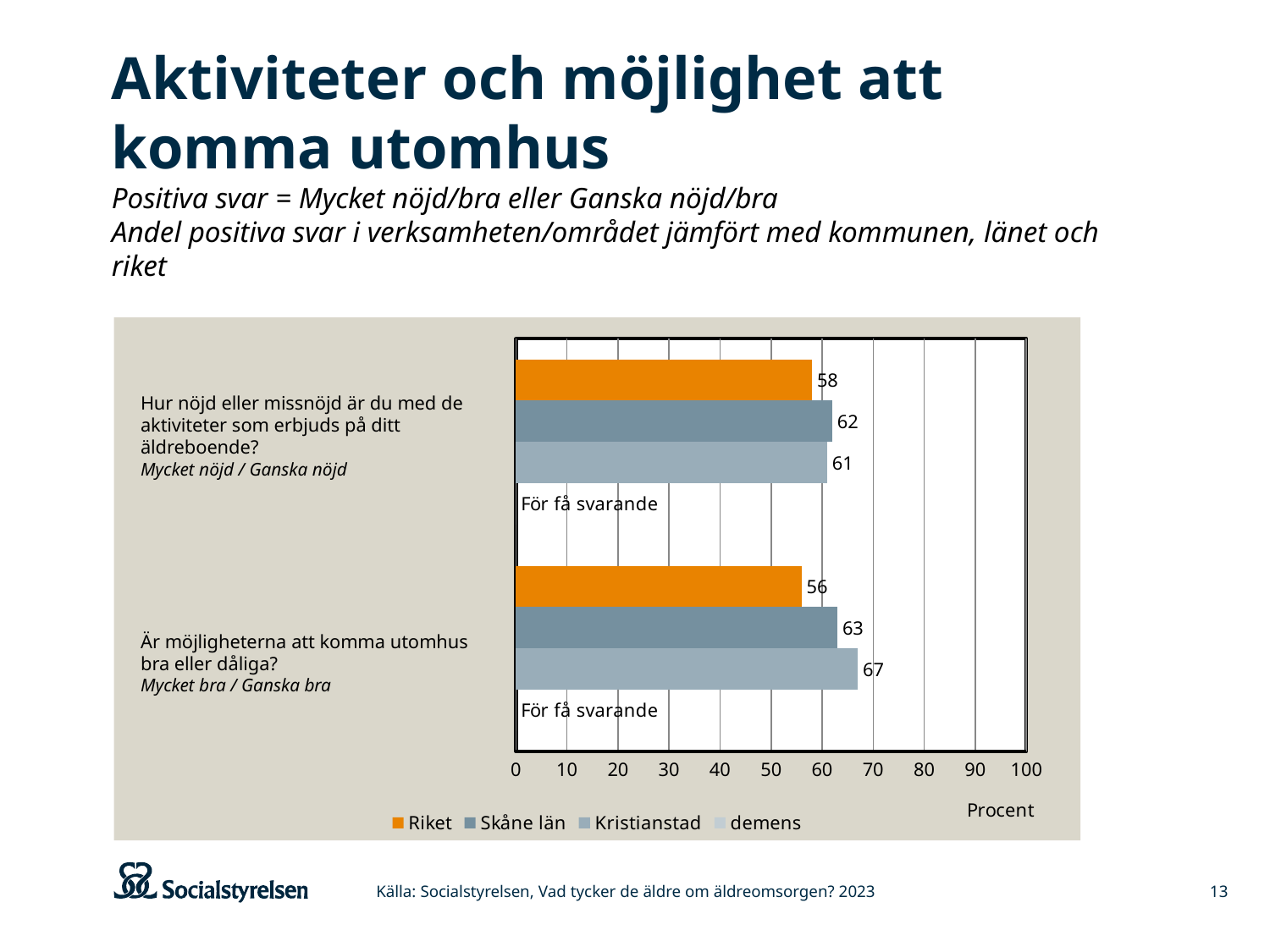
What is the maximum value shown on the x axis? 100 What is the value for Kristianstad for the question about opportunities to get outdoors (Är möjligheterna att komma utomhus bra eller dåliga?)? 67 What unit label is shown under the x axis? Procent What is shown for the demens series for the question about opportunities to get outdoors? För få svarande Which series has the lowest value for the question about activities offered at the elderly home? Riket What kind of chart is shown on the slide? Bar chart How many series does the legend list? 4 What is the value for Riket for the question about activities offered at the elderly home (Hur nöjd eller missnöjd är du med de aktiviteter som erbjuds på ditt äldreboende?)? 58 What is the difference between Kristianstad and Riket for the question about opportunities to get outdoors? 11 What is the value for Skåne län for the question about activities offered at the elderly home? 62 Which is larger for the question about activities offered at the elderly home: Skåne län or Kristianstad? Skåne län Which series has the highest value for the question about opportunities to get outdoors? Kristianstad